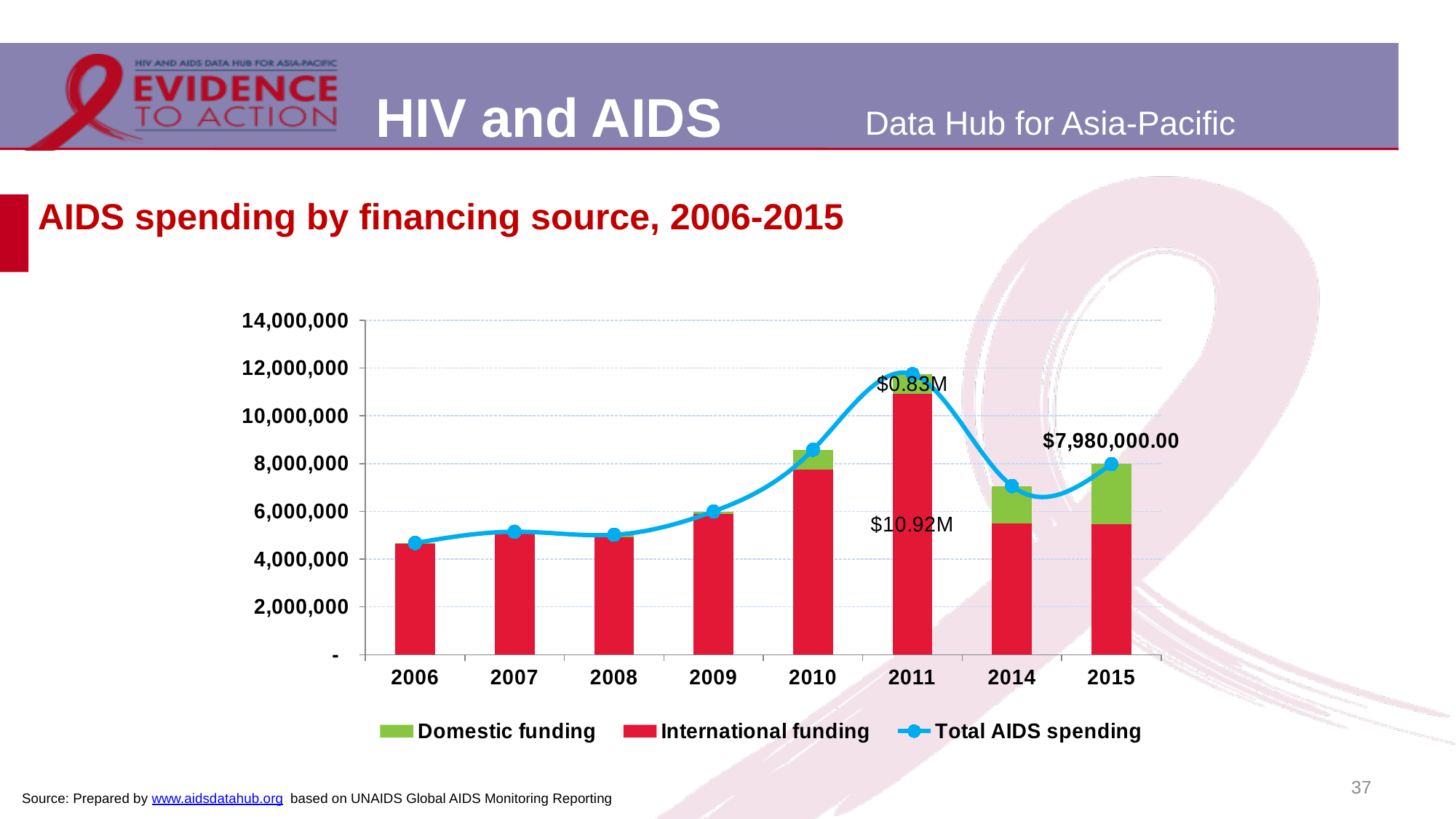
Does Total AIDS spending rise or fall from 2008 to 2011? rise How many series does the legend list? 3 Which year has the highest Total AIDS spending? 2011 Is the Total AIDS spending for 2014 greater or less than 8,000,000? less What value is labelled for Total AIDS spending in 2015? $7,980,000.00 Is the Total AIDS spending for 2006 greater or less than 6,000,000? less What kind of chart is this? Stacked bar chart with a line Which year has the larger Total AIDS spending, 2009 or 2010? 2010 Is the Total AIDS spending for 2011 greater or less than 10,000,000? greater What is the title of the chart? AIDS spending by financing source, 2006-2015 How many years are shown on the x axis? 8 Which colour represents Domestic funding in the chart? Green